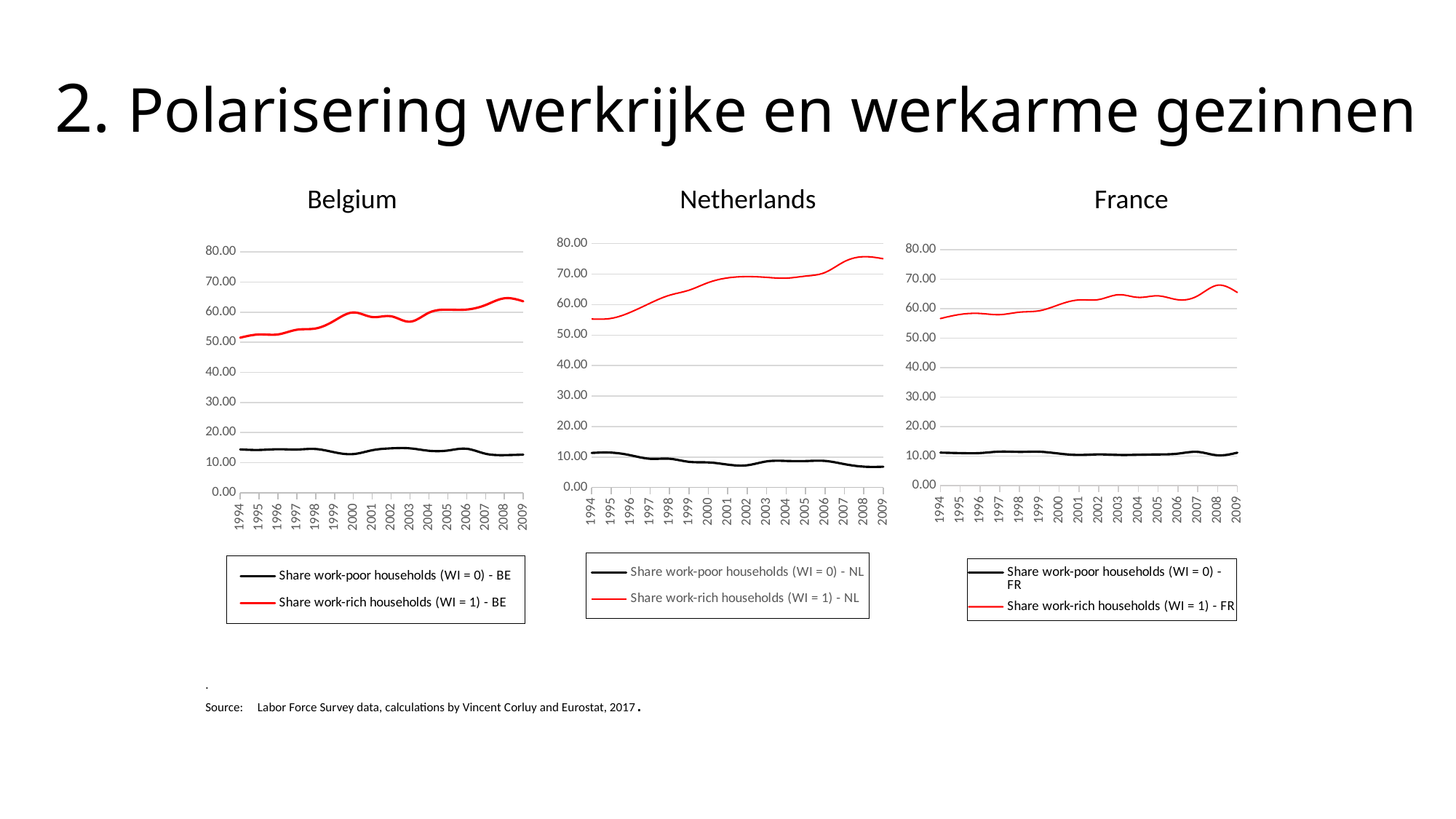
In the Belgium chart, is the value for work-rich households in 2009 greater or less than 60? greater In the Netherlands chart, is the value for work-poor households in 2009 greater or less than 10? less What kind of chart is the Belgium chart? line chart In the France chart, is the value for work-rich households in 1994 greater or less than 60? less How many series does the legend of the Netherlands chart list? 2 In the Netherlands chart, does the share of work-rich households rise or fall from 1994 to 2009? rise In the Netherlands chart, does the share of work-poor households rise or fall from 1994 to 2009? fall How many years are shown on the x axis of the France chart? 16 In the Belgium chart, which series is drawn in red? Share work-rich households (WI = 1) - BE Which is larger in 2009: the share of work-rich households in the Netherlands chart or in the Belgium chart? Netherlands What is the title of the chart on the right of the slide? France